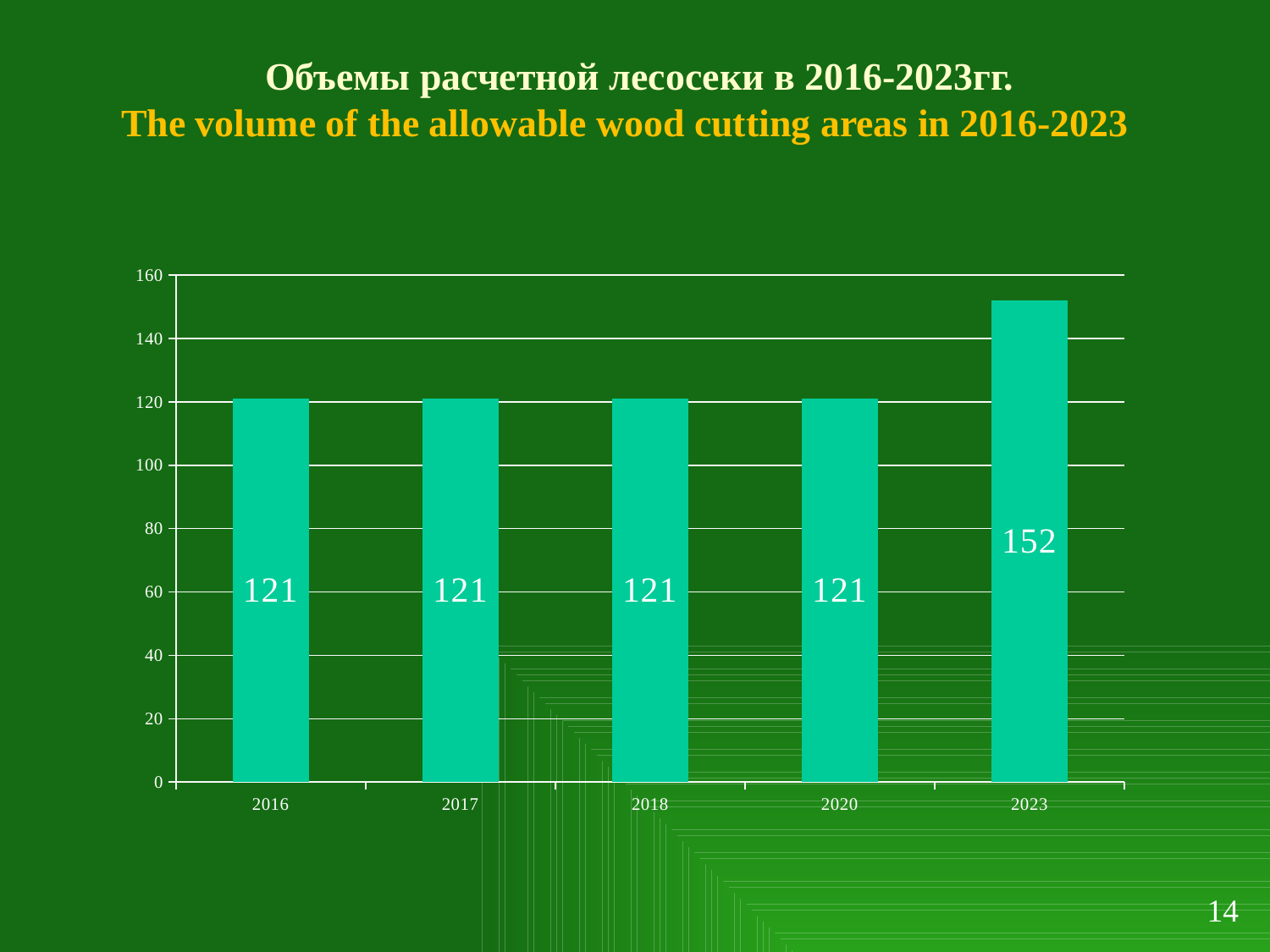
What is the value for 2020? 121 How many years are shown on the x axis? 5 Do the values rise or fall from 2020 to 2023? rise Which year has the highest value? 2023 What is the value for 2016? 121 Which is larger, the value for 2023 or the value for 2017? 2023 What kind of chart is shown on the slide? bar chart What is the difference between the values for 2023 and 2018? 31 What is the value for 2023? 152 What is the English title of the chart? The volume of the allowable wood cutting areas in 2016-2023 Is the value for 2023 greater or less than 140? greater Is the value for 2017 greater or less than 140? less